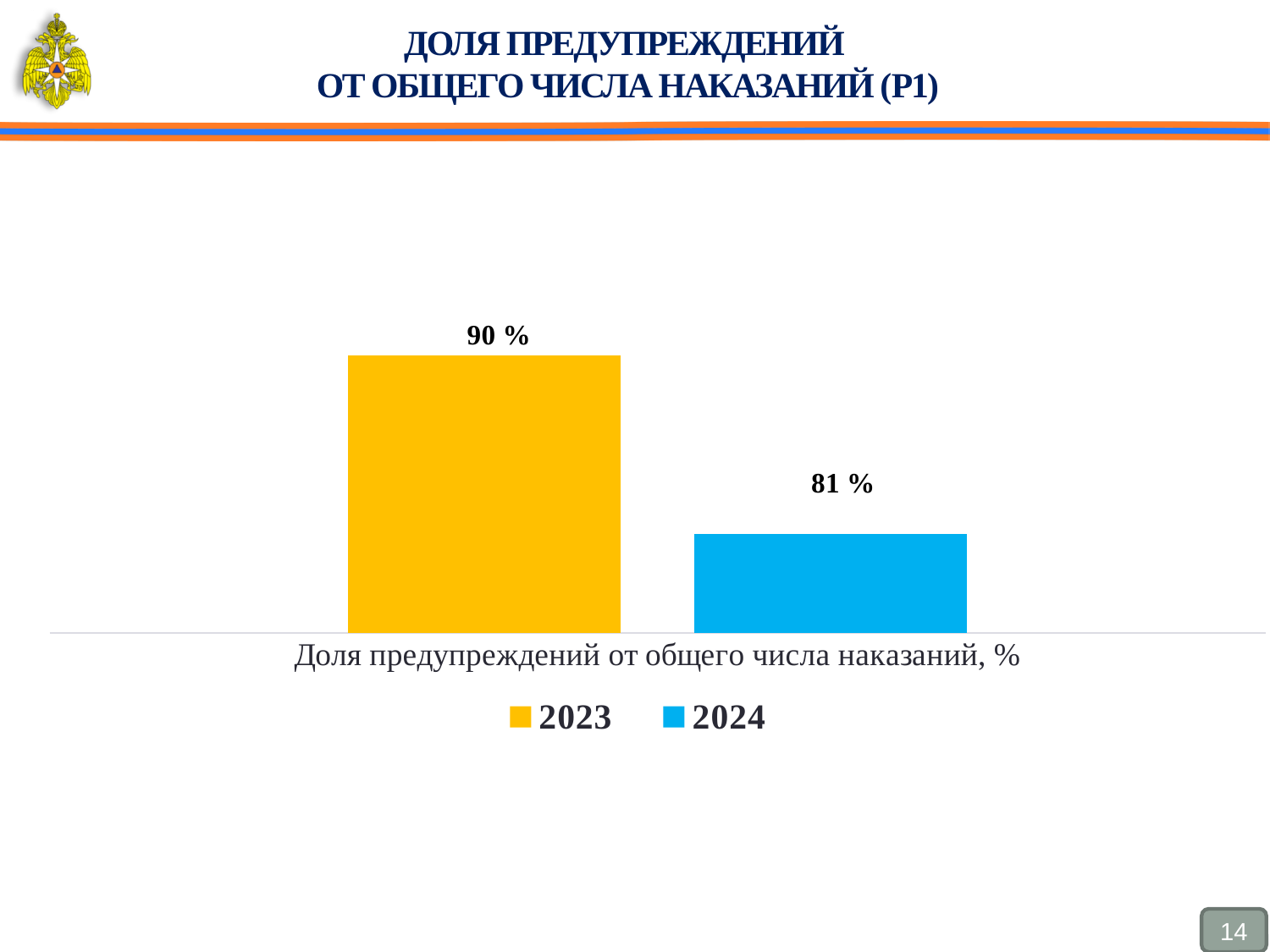
Which year has the lower share of warnings among total penalties? 2024 Is the value for 2023 larger or smaller than the value for 2024? larger How many bars are plotted in the chart? 2 What is the difference between the 2023 and 2024 values? 9 % Which year has the higher share of warnings among total penalties? 2023 What colour is the bar for 2024? blue How many series does the legend list? 2 What is the category label shown under the bars? Доля предупреждений от общего числа наказаний, % What is the value for 2024 in the chart? 81 % What kind of chart is shown on the slide? bar chart What is the value for 2023 in the chart? 90 % Does the share of warnings rise or fall from 2023 to 2024? fall